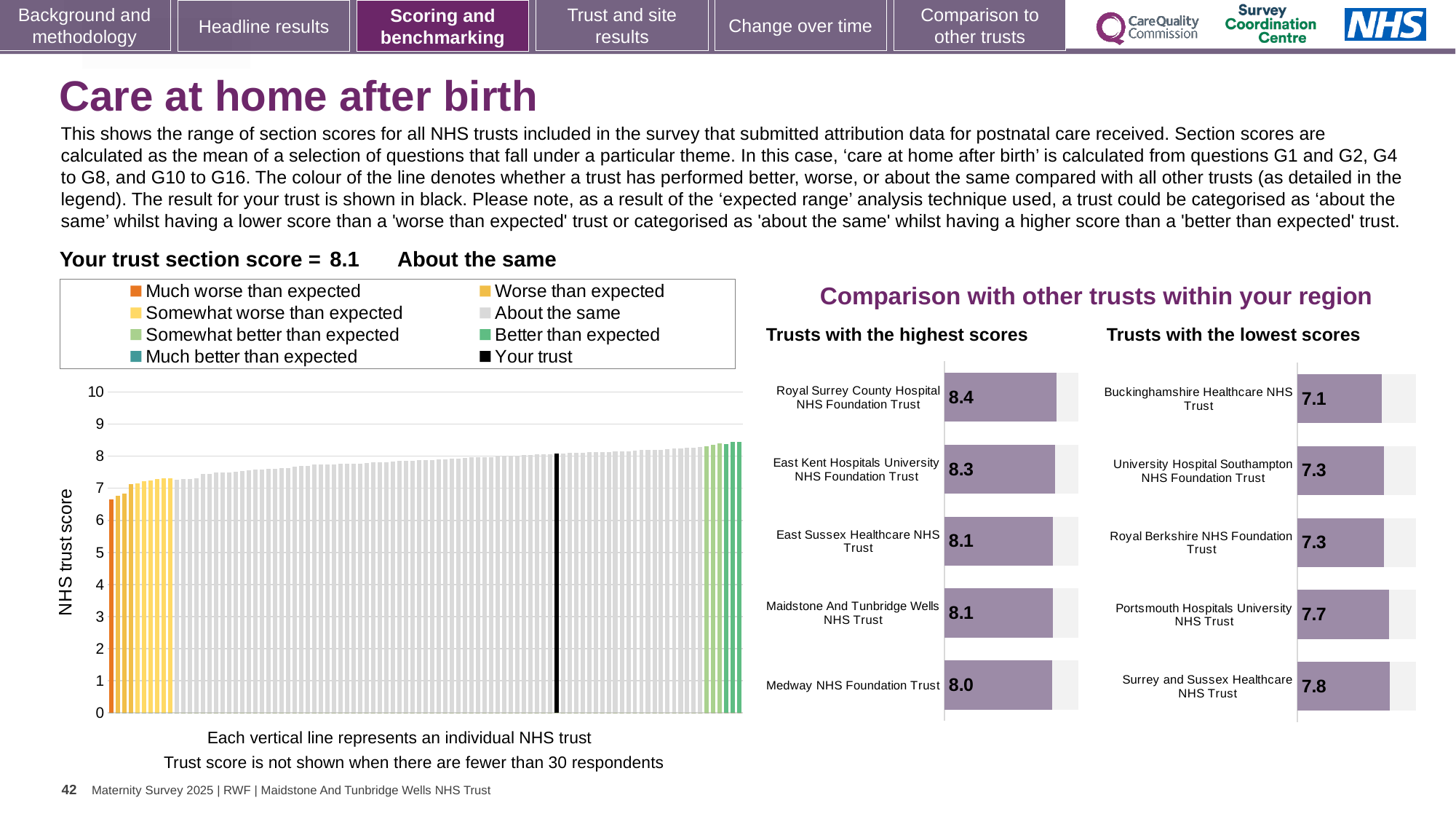
In the 'Trusts with the lowest scores' chart, which trust has the lowest score? Buckinghamshire Healthcare NHS Trust In the 'Trusts with the highest scores' chart, which trust has the highest score? Royal Surrey County Hospital NHS Foundation Trust In the 'Trusts with the lowest scores' chart, which has the larger score: Surrey and Sussex Healthcare NHS Trust or University Hospital Southampton NHS Foundation Trust? Surrey and Sussex Healthcare NHS Trust How many entries does the legend of the NHS trust score chart list? 8 In the 'Trusts with the lowest scores' chart, what is the score for Portsmouth Hospitals University NHS Trust? 7.7 How many trusts are shown in the 'Trusts with the lowest scores' chart? 5 In the 'Trusts with the highest scores' chart, what is the score for Royal Surrey County Hospital NHS Foundation Trust? 8.4 In the NHS trust score chart on the left, do the bar values rise or fall from left to right? Rise In the 'Trusts with the lowest scores' chart, what is the score for Buckinghamshire Healthcare NHS Trust? 7.1 In the 'Trusts with the highest scores' chart, what is the difference between the scores of Royal Surrey County Hospital NHS Foundation Trust and Medway NHS Foundation Trust? 0.4 What kind of chart is the NHS trust score chart on the left of the slide? Bar chart In the 'Trusts with the highest scores' chart, what is the score for Medway NHS Foundation Trust? 8.0